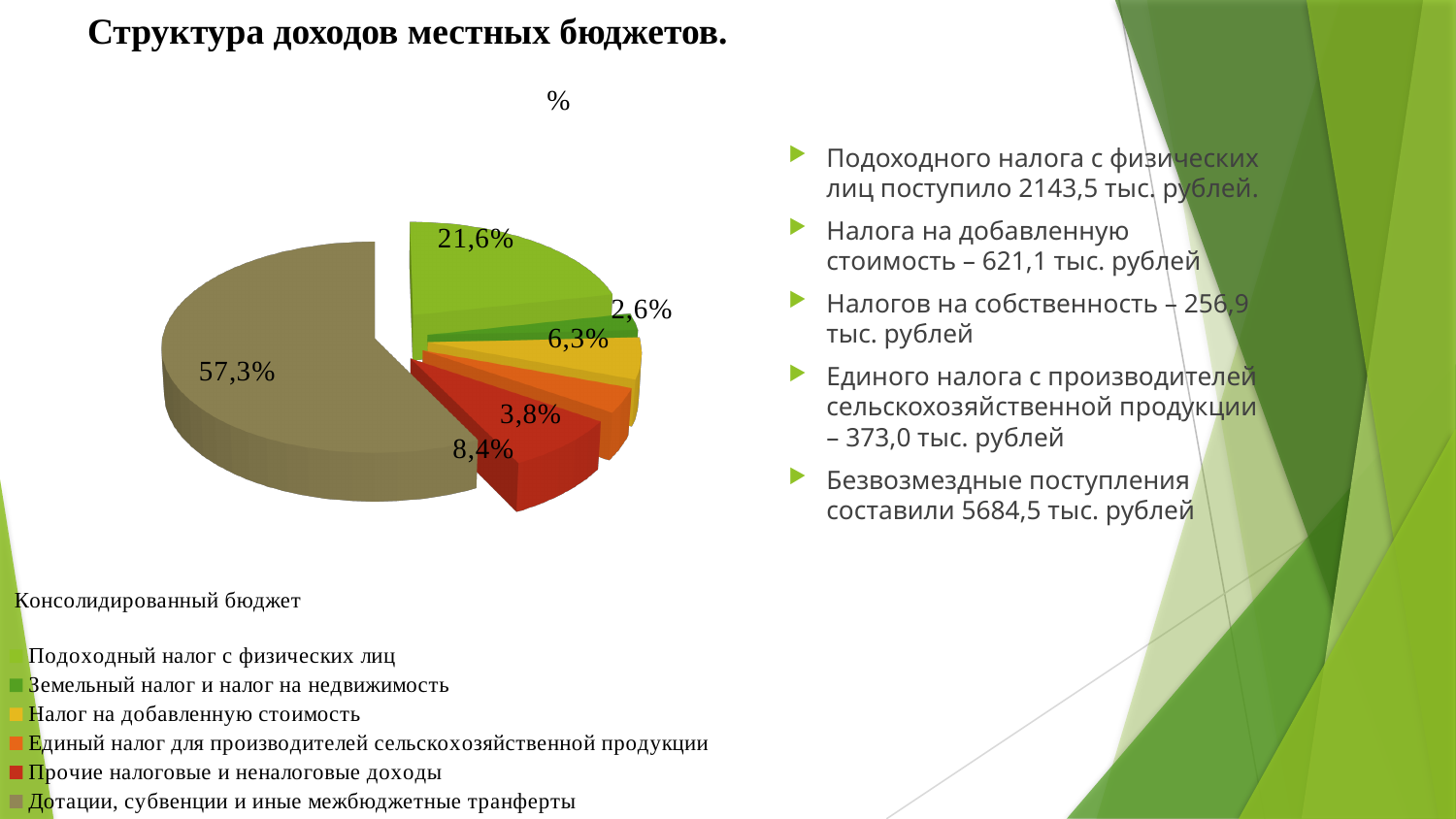
What share of the pie does "Прочие налоговые и неналоговые доходы" have? 8,4% Which category has the largest slice of the pie? Дотации, субвенции и иные межбюджетные трансферты What share of the pie does "Единый налог для производителей сельскохозяйственной продукции" have? 3,8% What share of the pie does "Подоходный налог с физических лиц" have? 21,6% What type of chart is shown on the slide? pie chart What is the title shown above the pie chart? % What is the difference in percentage points between "Дотации, субвенции и иные межбюджетные трансферты" and "Подоходный налог с физических лиц"? 35,7 What share of the pie does "Дотации, субвенции и иные межбюджетные трансферты" have? 57,3% How many categories does the pie chart legend list? 6 Which is larger: the share for "Прочие налоговые и неналоговые доходы" or for "Налог на добавленную стоимость"? Прочие налоговые и неналоговые доходы Which category has the smallest slice of the pie? Земельный налог и налог на недвижимость What share of the pie does "Налог на добавленную стоимость" have? 6,3%